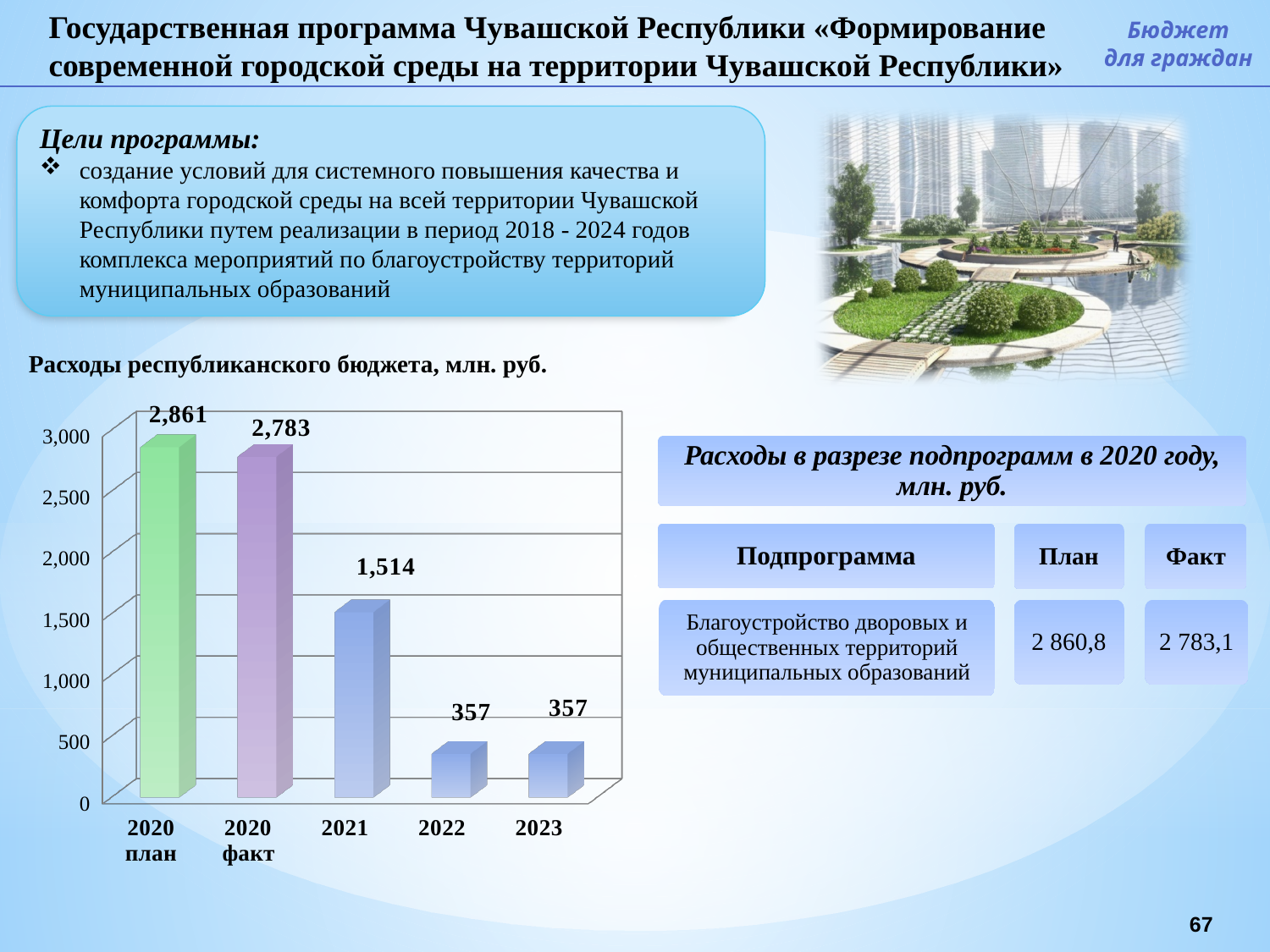
Which is larger, the value for 2021 or the value for 2023? 2021 What is the value for 2022 in the chart? 357 How many categories are shown on the x axis of the chart? 5 What is the difference between the values for 2020 факт and 2021? 1,269 What kind of chart is shown on the slide? bar chart What is the difference between the values for 2020 план and 2020 факт? 78 What is the value for 2020 факт in the chart? 2,783 Which category has the highest value in the chart? 2020 план Is the value for 2021 greater or less than 1,000? greater What is the value for 2021 in the chart? 1,514 What is the value for 2020 план in the chart 'Расходы республиканского бюджета, млн. руб.'? 2,861 What is the title of the chart on the slide? Расходы республиканского бюджета, млн. руб.